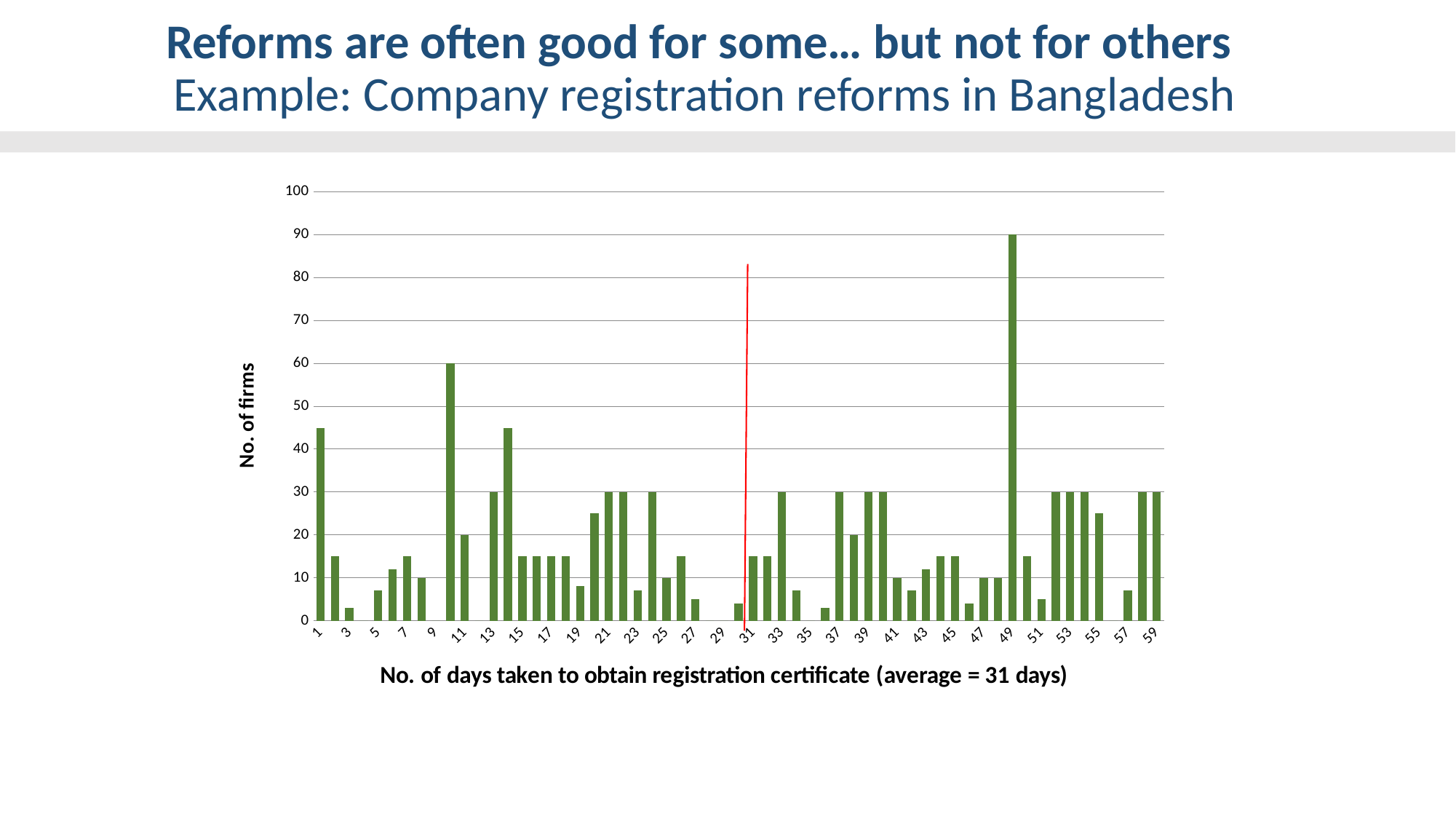
What is the number of firms for 49 days? 90 What is the label of the y axis? No. of firms Which has more firms, 49 days or 1 day? 49 days Which has more firms, 1 day or 3 days? 1 day According to the x-axis label, what is the average number of days taken to obtain a registration certificate? 31 days Is the number of firms for 3 days greater or less than 10? less Is the number of firms for 49 days greater or less than 80? greater Is the number of firms for 31 days greater or less than 20? less At which number of days is the number of firms highest? 49 What kind of chart is shown on the slide? bar chart